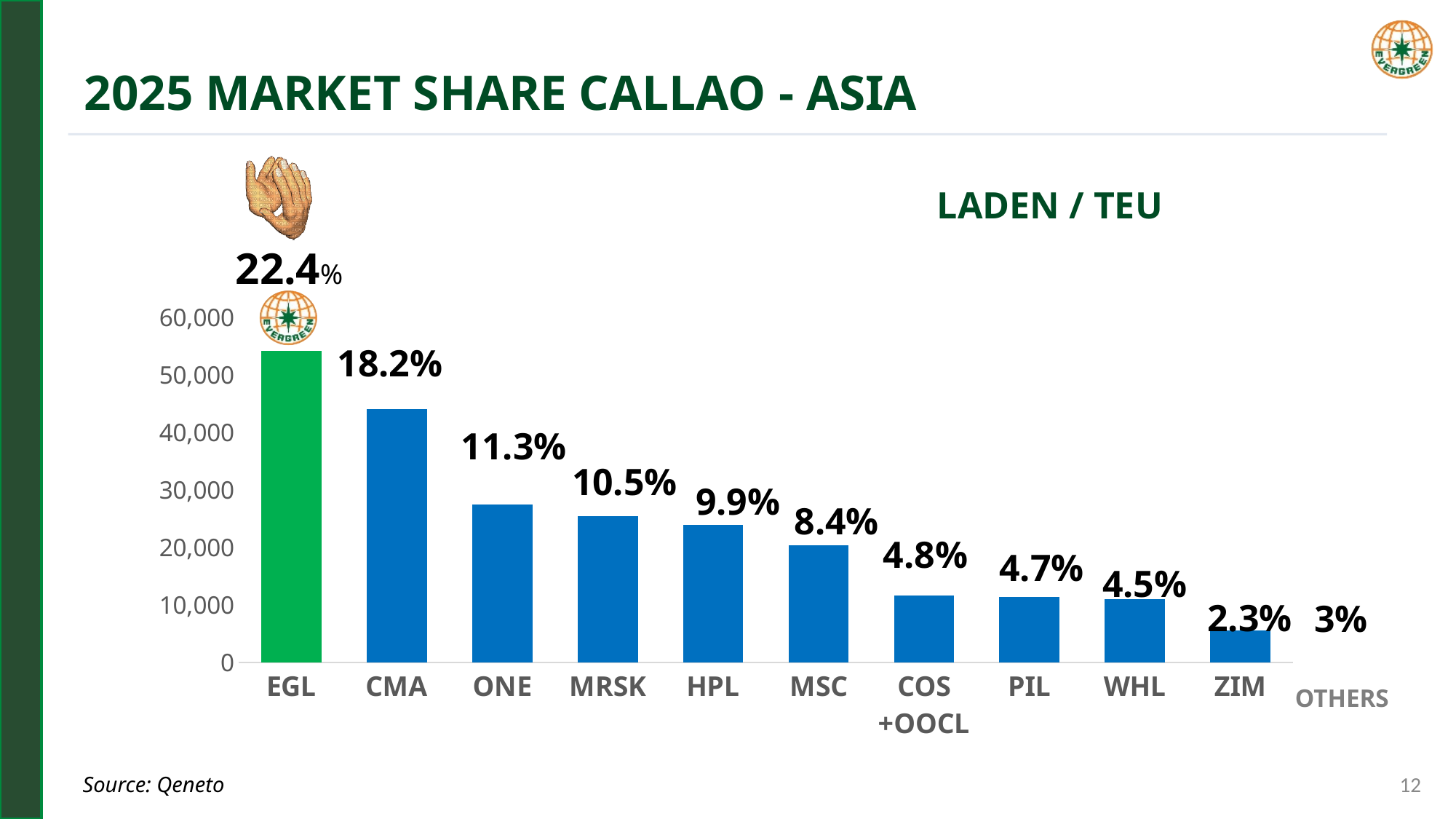
What market share percentage is shown for COS+OOCL? 4.8% What market share percentage is shown for EGL? 22.4% Which carrier has the highest market share? EGL Which named carrier has the lowest market share? ZIM What market share percentage is shown for CMA? 18.2% What kind of chart is shown on the slide? Bar chart Do the bar values rise or fall from left to right along the x axis? Fall Which has the larger market share, PIL or WHL? PIL What market share percentage is shown for OTHERS? 3% Is the value for EGL greater or less than 50,000? greater Is the value for ONE greater or less than 30,000? less What is the difference in percentage points between EGL's and CMA's market share? 4.2